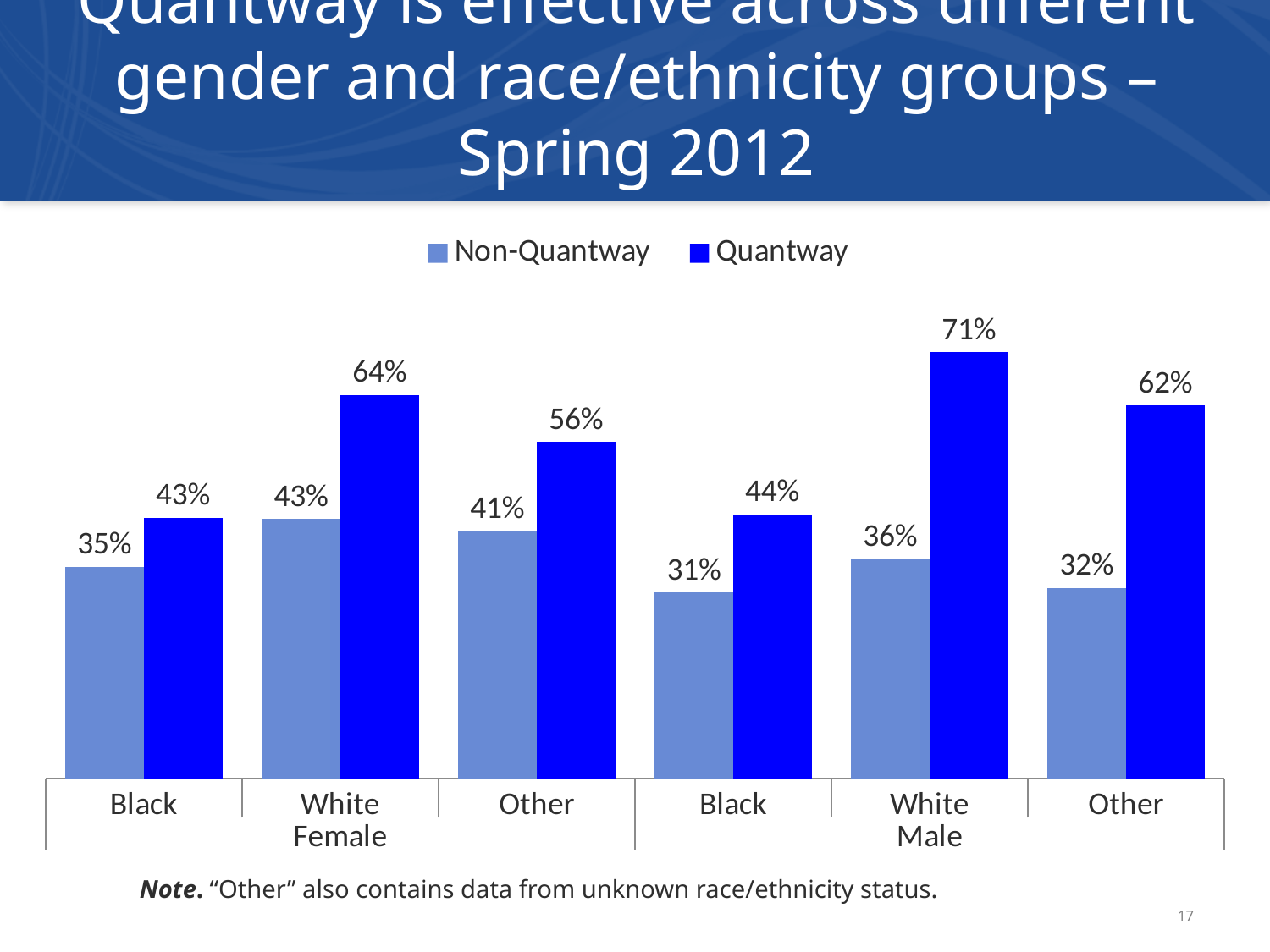
Which is larger: the Quantway value for Other Female or the Quantway value for Black Male? Other Female Which group has the highest Quantway value? White Male What kind of chart is shown on the slide? Bar chart What is the difference between the Quantway and Non-Quantway values for Black Female? 8% Which group has the lowest Non-Quantway value? Black Male What are the two series named in the legend? Non-Quantway and Quantway What is the Quantway value for Other Male? 62% How many groups are shown along the x axis? 6 What is the Non-Quantway value for Black Male? 31% How many series does the legend list? 2 What is the Quantway value for White Female? 64% What is the difference between the Quantway and Non-Quantway values for White Male? 35%